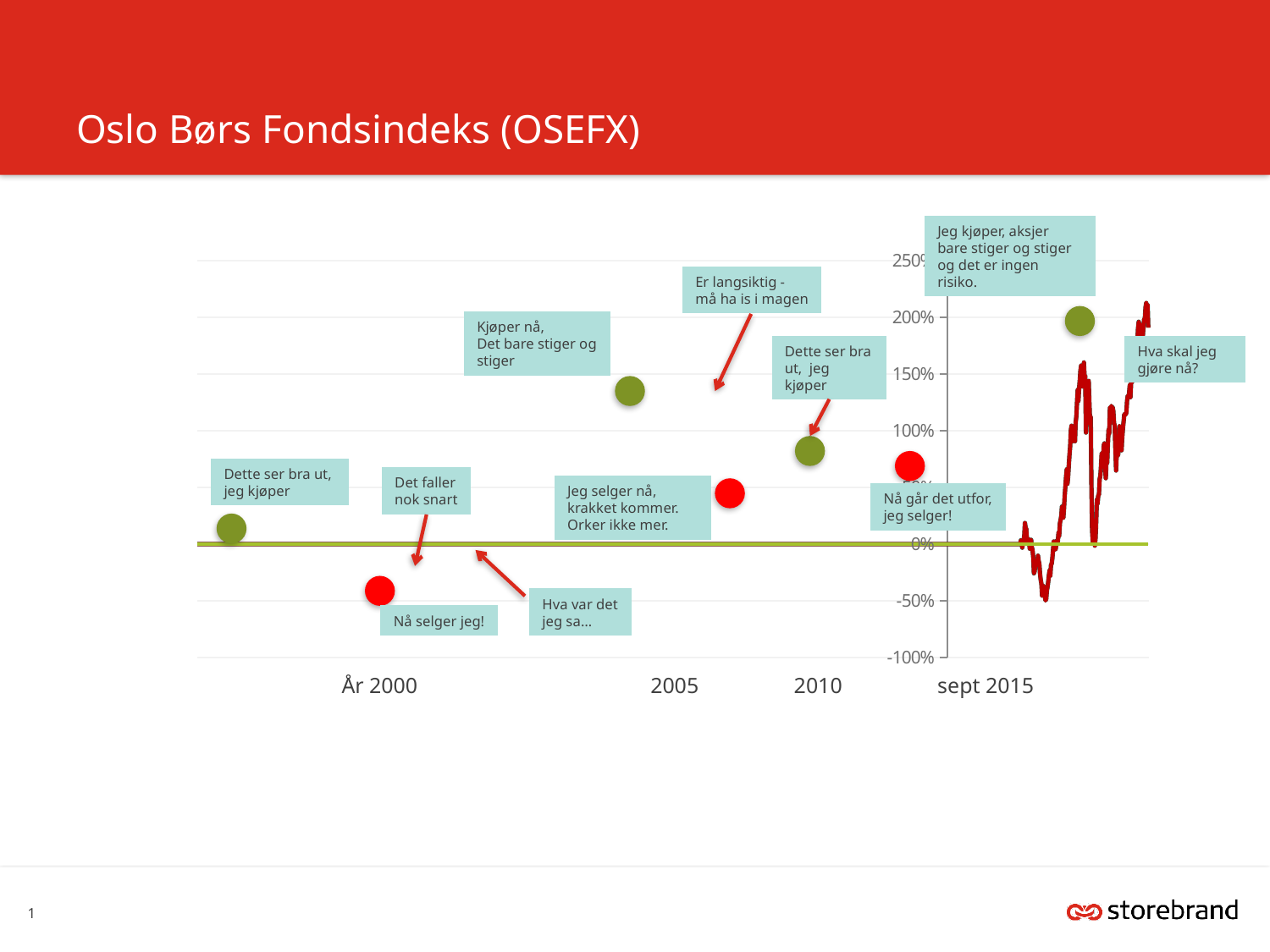
Is the lowest point of the index line greater or less than 0%? less How many labels are shown along the x axis? 4 What is the last label on the x axis? sept 2015 Is the highest point of the index line greater or less than 200%? greater Does the index line end higher or lower than where it starts? higher What is the lowest value shown on the y axis? -100% What is the first label on the x axis? År 2000 What colour is the plotted index line? red What is the title of the chart on the slide? Oslo Børs Fondsindeks (OSEFX) What is the highest value shown on the y axis? 250% What kind of chart is shown on the slide? line chart